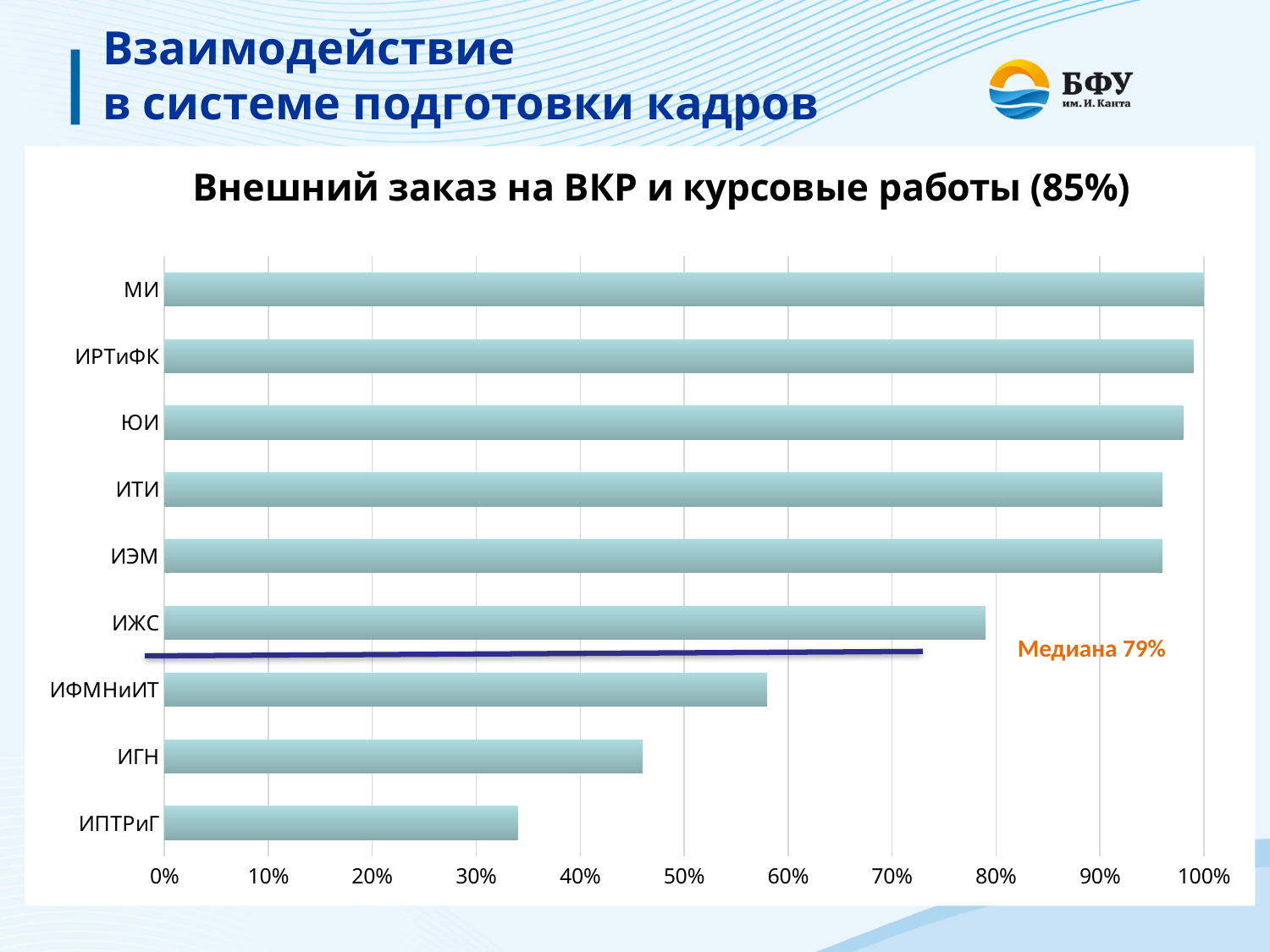
What kind of chart is shown on the slide? bar chart What is the value for МИ? 100% What median value is annotated on the chart? Медиана 79% Is the value for ИЖС greater or less than 70%? greater What is the title of the chart? Внешний заказ на ВКР и курсовые работы (85%) How many institutes (categories) are plotted in the chart? 9 Is the value for ИФМНиИТ greater or less than 50%? greater Which institute has the highest value in the chart? МИ Is the value for ИГН greater or less than 50%? less Which is larger, the value for ИЖС or the value for ИФМНиИТ? ИЖС Which institute has the lowest value in the chart? ИПТРиГ